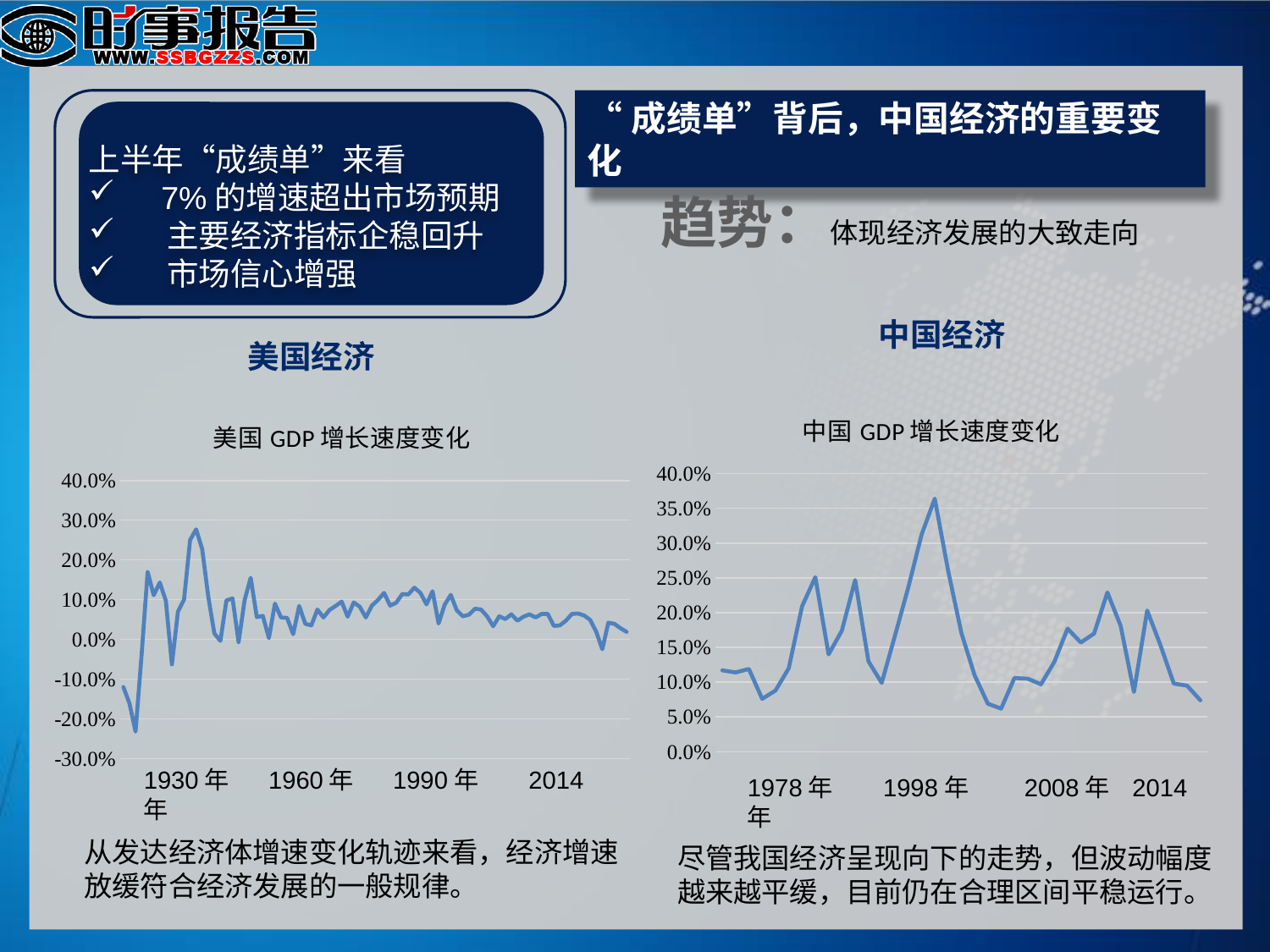
In the "中国 GDP 增长速度变化" chart, does the line overall rise or fall from 1978年 to 2014年? fall What kind of chart is the "中国 GDP 增长速度变化" chart on the right? line chart In the "中国 GDP 增长速度变化" chart, is the highest point of the line greater or less than 30.0%? greater In the "中国 GDP 增长速度变化" chart, is the value at 1978年 greater or less than 10.0%? greater In the "中国 GDP 增长速度变化" chart, is the value at the final point (2014年) greater or less than 10.0%? less How many lines are plotted in the "中国 GDP 增长速度变化" chart? 1 What is the highest value shown on the y axis of the "中国 GDP 增长速度变化" chart? 40.0% In the "美国 GDP 增长速度变化" chart, does the line overall rise or fall from 1960年 to 2014年? fall What is the lowest value shown on the y axis of the "美国 GDP 增长速度变化" chart? -30.0% What kind of chart is the "美国 GDP 增长速度变化" chart on the left? line chart